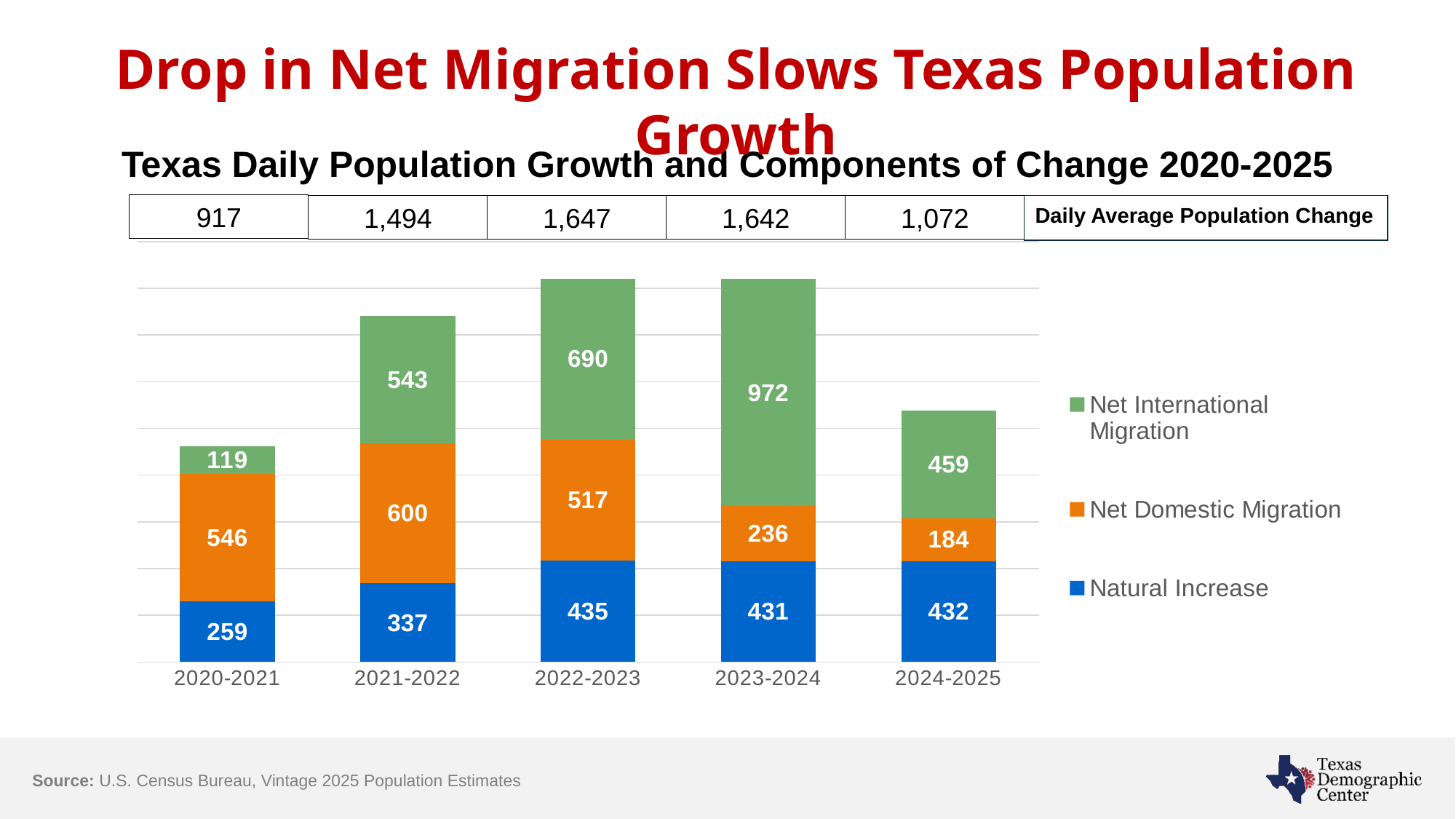
What is the Daily Average Population Change shown for 2022-2023? 1,647 What is the Net International Migration value for 2023-2024? 972 What is the Natural Increase value for 2020-2021? 259 In which period is Net Domestic Migration highest? 2021-2022 What is the difference between Net International Migration in 2023-2024 and in 2024-2025? 513 In which period is Natural Increase lowest? 2020-2021 What kind of chart is shown? Stacked bar chart How many periods are shown on the x axis? 5 What is the Net Domestic Migration value for 2024-2025? 184 How many series does the legend list? 3 Which period has the larger Net Domestic Migration, 2020-2021 or 2021-2022? 2021-2022 In which period is Net International Migration highest? 2023-2024